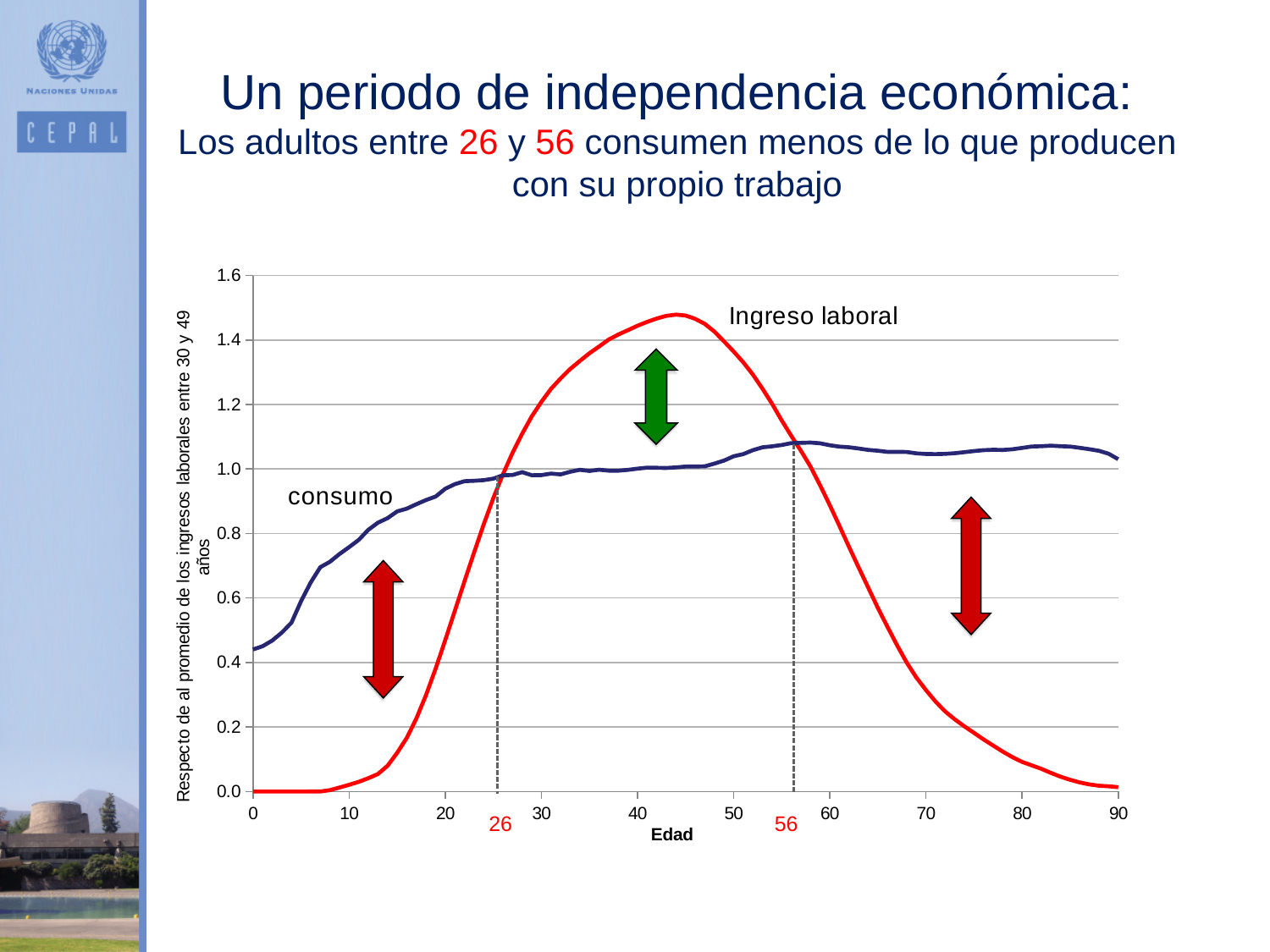
Is the value of 'Ingreso laboral' at age 40 greater or less than 1.2? greater At age 10, which is higher, 'consumo' or 'Ingreso laboral'? consumo What colour is the 'Ingreso laboral' line? red Is the value of 'consumo' at age 0 greater or less than 0.6? less What kind of chart is shown on the slide? line chart What is the title of the x axis of the chart? Edad At age 70, which is higher, 'consumo' or 'Ingreso laboral'? consumo Does the 'Ingreso laboral' line rise or fall between age 60 and age 90? falls Does the 'consumo' line rise or fall between age 0 and age 20? rises How many lines (series) are plotted on the chart? 2 Is the value of 'Ingreso laboral' at age 80 greater or less than 0.2? less At age 40, which is higher, 'consumo' or 'Ingreso laboral'? Ingreso laboral